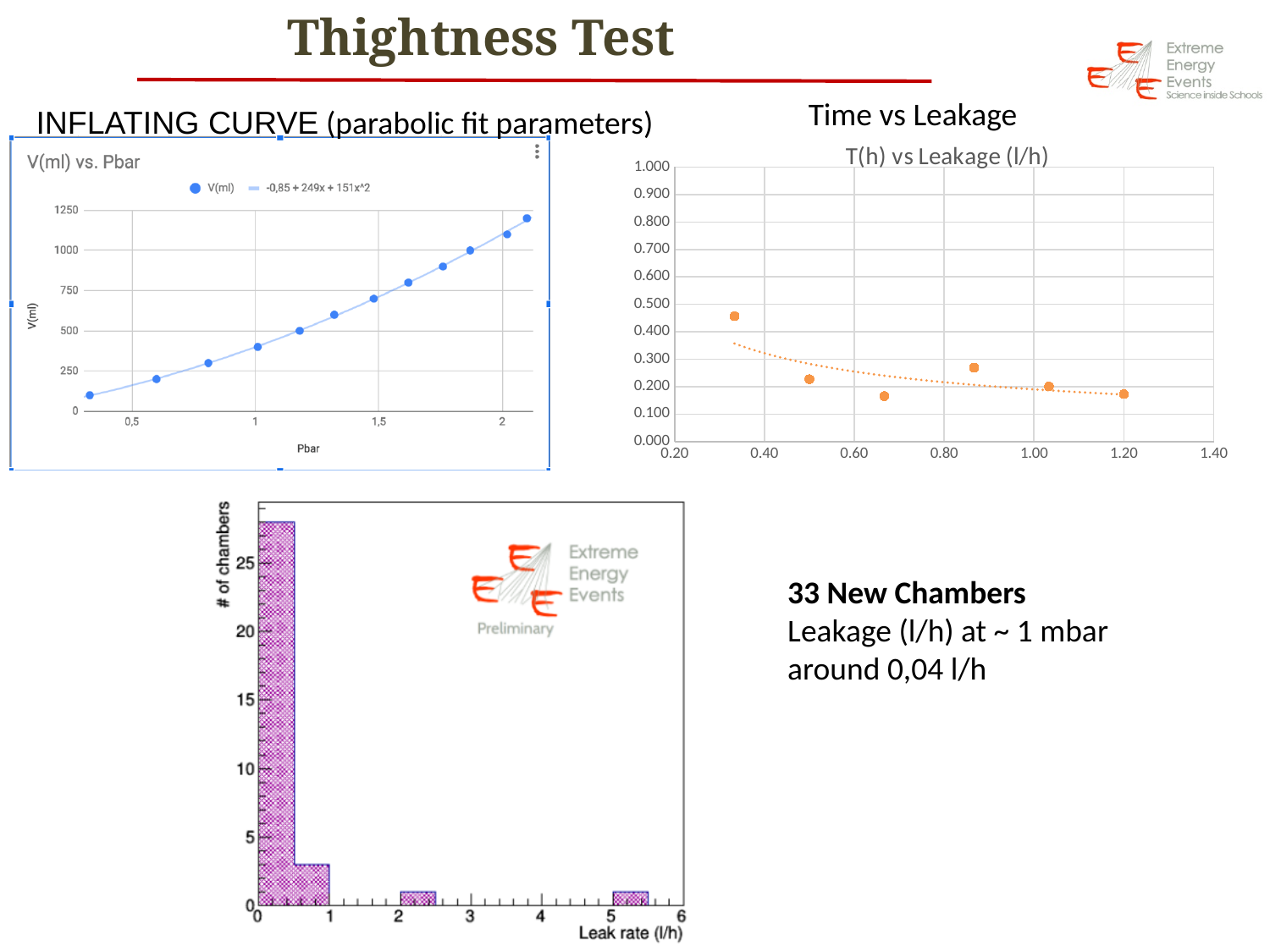
In the 'V(ml) vs. Pbar' chart, is the value at Pbar = 2 greater or less than 1000? greater In the 'V(ml) vs. Pbar' chart, what fit equation is shown in the legend? -0,85 + 249x + 151x^2 In the 'V(ml) vs. Pbar' chart, is the value at Pbar = 0.5 greater or less than 250? less In the bottom histogram of '# of chambers' vs 'Leak rate (l/h)', which leak-rate bin has the most chambers? 0 to 0.5 l/h In the 'V(ml) vs. Pbar' chart, do the values rise or fall as Pbar increases? rise In the 'T(h) vs Leakage (l/h)' chart, how many data points are plotted? 6 What kind of chart is the 'V(ml) vs. Pbar' chart at the top left? scatter chart with a fit line In the bottom histogram of '# of chambers' vs 'Leak rate (l/h)', is the tallest bar greater or less than 25? greater In the 'T(h) vs Leakage (l/h)' chart, do the leakage values rise or fall as time increases? fall In the 'V(ml) vs. Pbar' chart, how many data points are plotted? 12